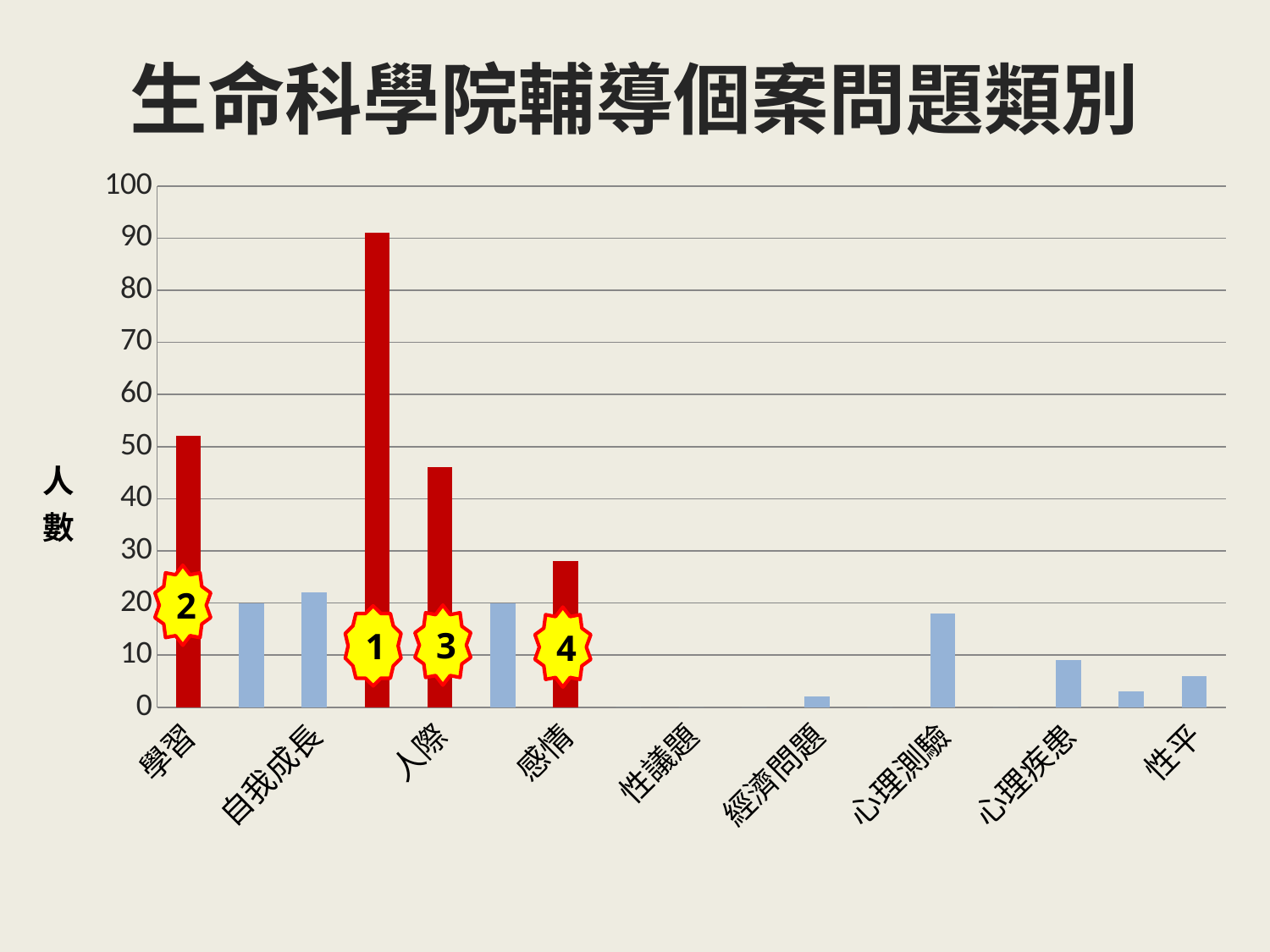
Is the value of the bar marked with badge 1 greater or less than 80? greater What kind of chart is shown on the slide? bar chart Is the value of the bar marked with badge 4 greater or less than 30? less How many category labels are shown along the x axis? 9 What is the label on the vertical axis? 人數 What is the title of the chart? 生命科學院輔導個案問題類別 Which numbered badge marks the tallest bar in the chart? 1 Is the value of the bar marked with badge 2 greater or less than 40? greater Which is larger, the bar marked with badge 1 or the bar marked with badge 2? badge 1 Which is larger, the bar marked with badge 3 or the bar marked with badge 4? badge 3